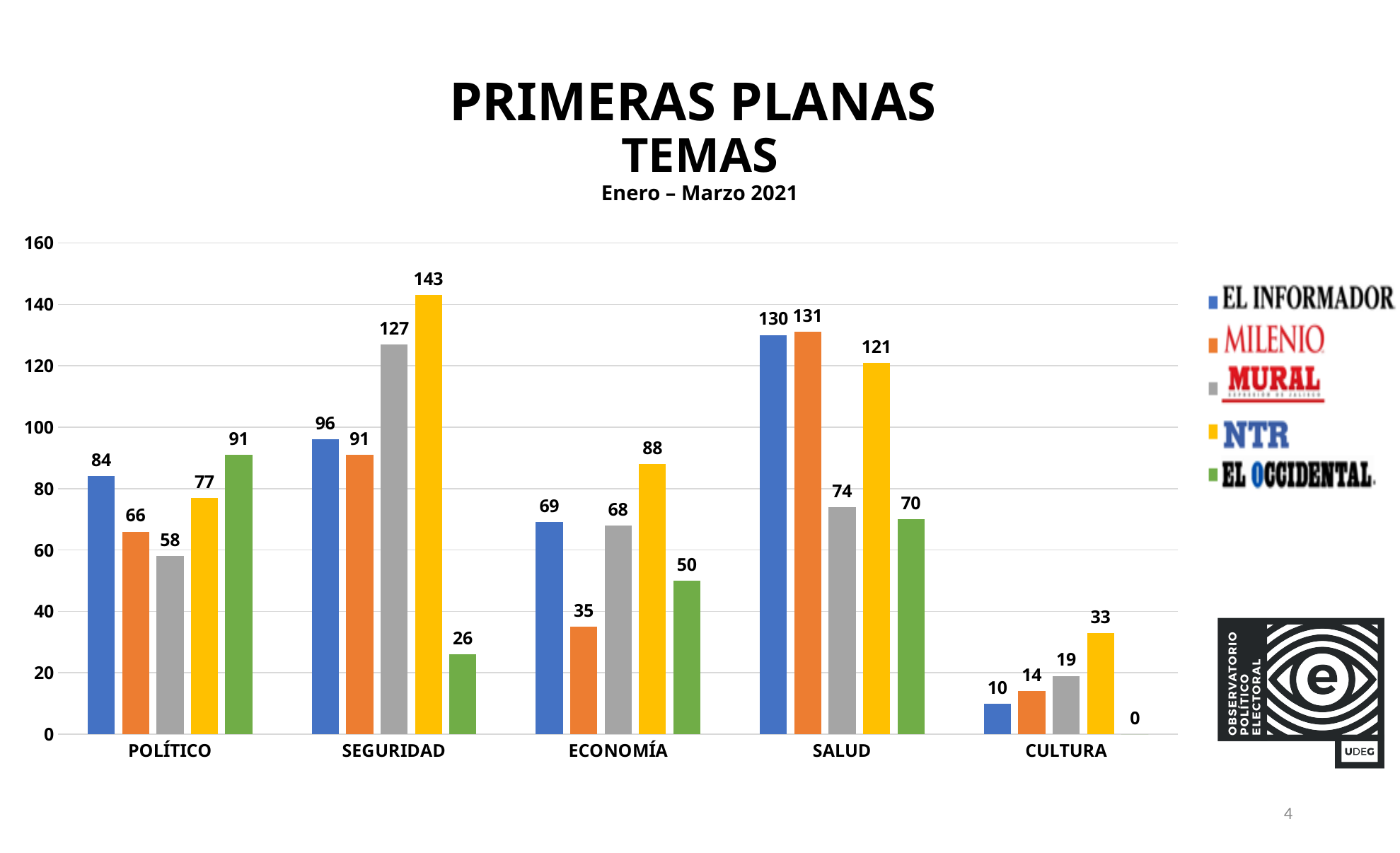
Which is larger in the SALUD category, MILENIO or NTR? MILENIO What is the value for EL OCCIDENTAL in the CULTURA category? 0 How many series does the legend list? 5 What kind of chart is shown on the slide? Bar chart What is the value for EL INFORMADOR in the SALUD category? 130 What is the value for NTR in the SEGURIDAD category? 143 What period does the chart subtitle indicate? Enero – Marzo 2021 What is the difference between MURAL and EL OCCIDENTAL in the SEGURIDAD category? 101 Which newspaper has the lowest value in the ECONOMÍA category? MILENIO How many topic categories are shown on the x axis? 5 Which newspaper has the highest value in the POLÍTICO category? EL OCCIDENTAL What is the total of the five values in the CULTURA category? 76